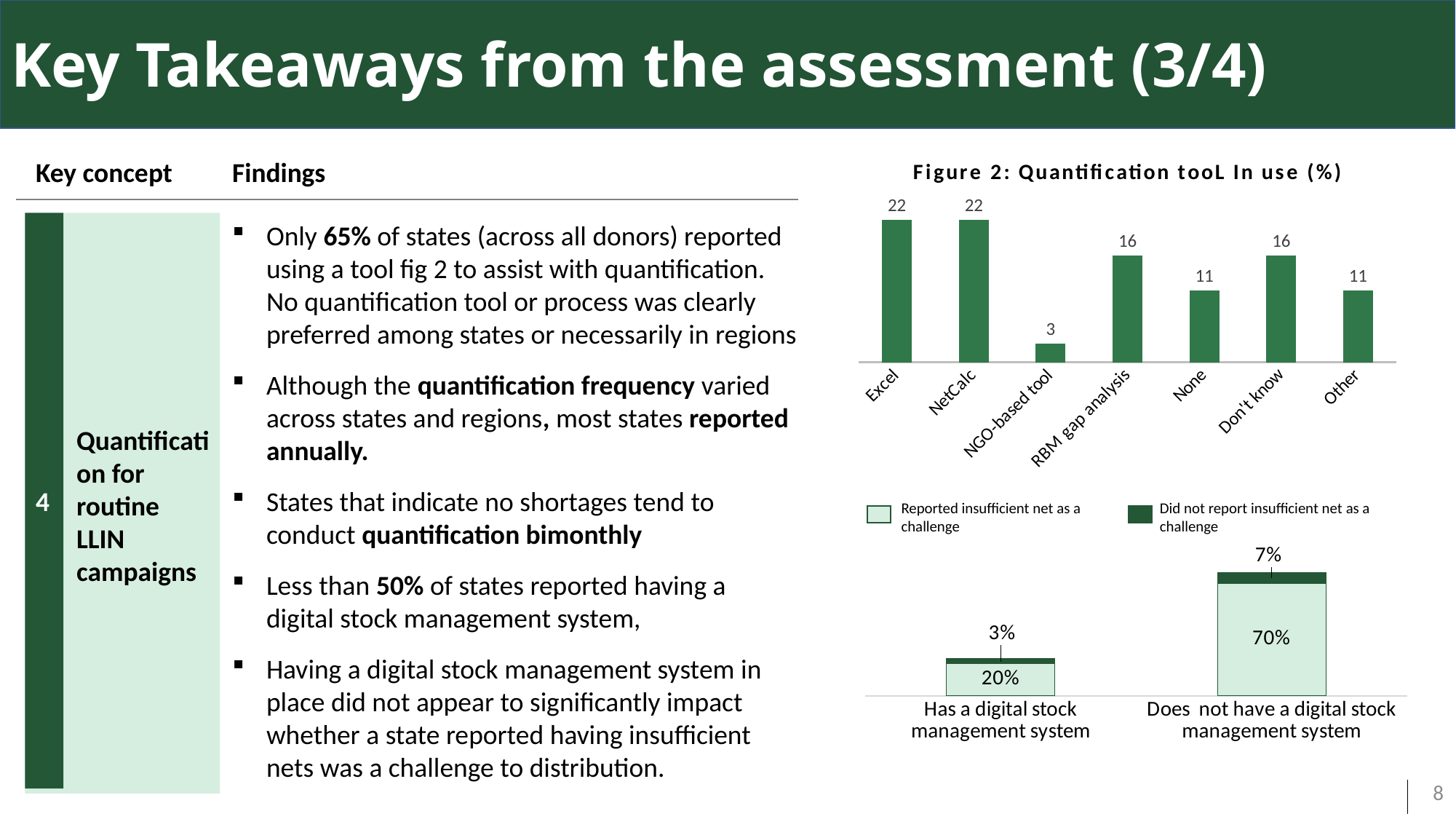
In the stacked bar chart at the bottom right, which category has the larger total bar? Does not have a digital stock management system In the stacked bar chart at the bottom right, what is the value for 'Reported insufficient net as a challenge' for states that have a digital stock management system? 20% In Figure 2: Quantification tool In use (%), which category has the lowest value? NGO-based tool What kind of chart is Figure 2: Quantification tool In use (%)? Bar chart How many categories are shown in Figure 2: Quantification tool In use (%)? 7 In Figure 2: Quantification tool In use (%), what is the difference between the values for NetCalc and None? 11 In Figure 2: Quantification tool In use (%), what is the value for RBM gap analysis? 16 How many series does the legend of the stacked bar chart at the bottom right list? 2 In the stacked bar chart at the bottom right, what is the value for 'Did not report insufficient net as a challenge' for states that do not have a digital stock management system? 7% In the stacked bar chart at the bottom right, what is the total of the bar for 'Does not have a digital stock management system'? 77% In Figure 2: Quantification tool In use (%), which is larger, the value for Don't know or the value for Other? Don't know In Figure 2: Quantification tool In use (%), what is the value for Excel? 22